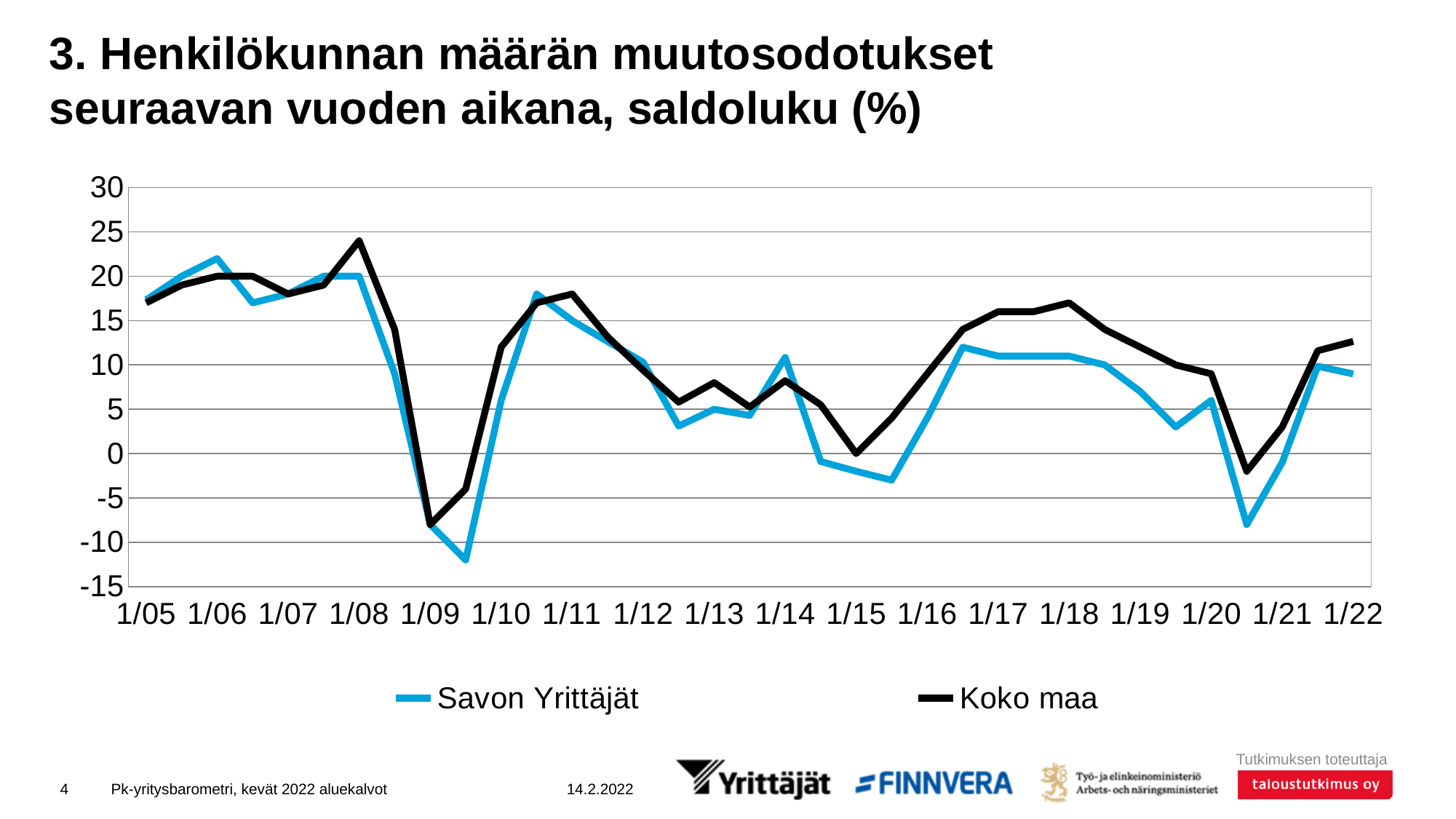
How many series does the legend list? 2 Which series reaches the lowest value anywhere on the chart? Savon Yrittäjät Does the Koko maa line rise or fall from 1/21 to 1/22? rise Is the value for Koko maa at 1/09 greater or less than -5? less At 1/22, which series has the larger value, Savon Yrittäjät or Koko maa? Koko maa Is the value for Koko maa at 1/14 greater or less than 10? less What kind of chart is shown on the slide? line chart At 1/18, which series has the larger value, Savon Yrittäjät or Koko maa? Koko maa Which series is drawn in blue? Savon Yrittäjät Which series reaches the highest value anywhere on the chart? Koko maa How many labels are shown on the x axis? 18 Is the value for Savon Yrittäjät at 1/08 greater or less than 15? greater